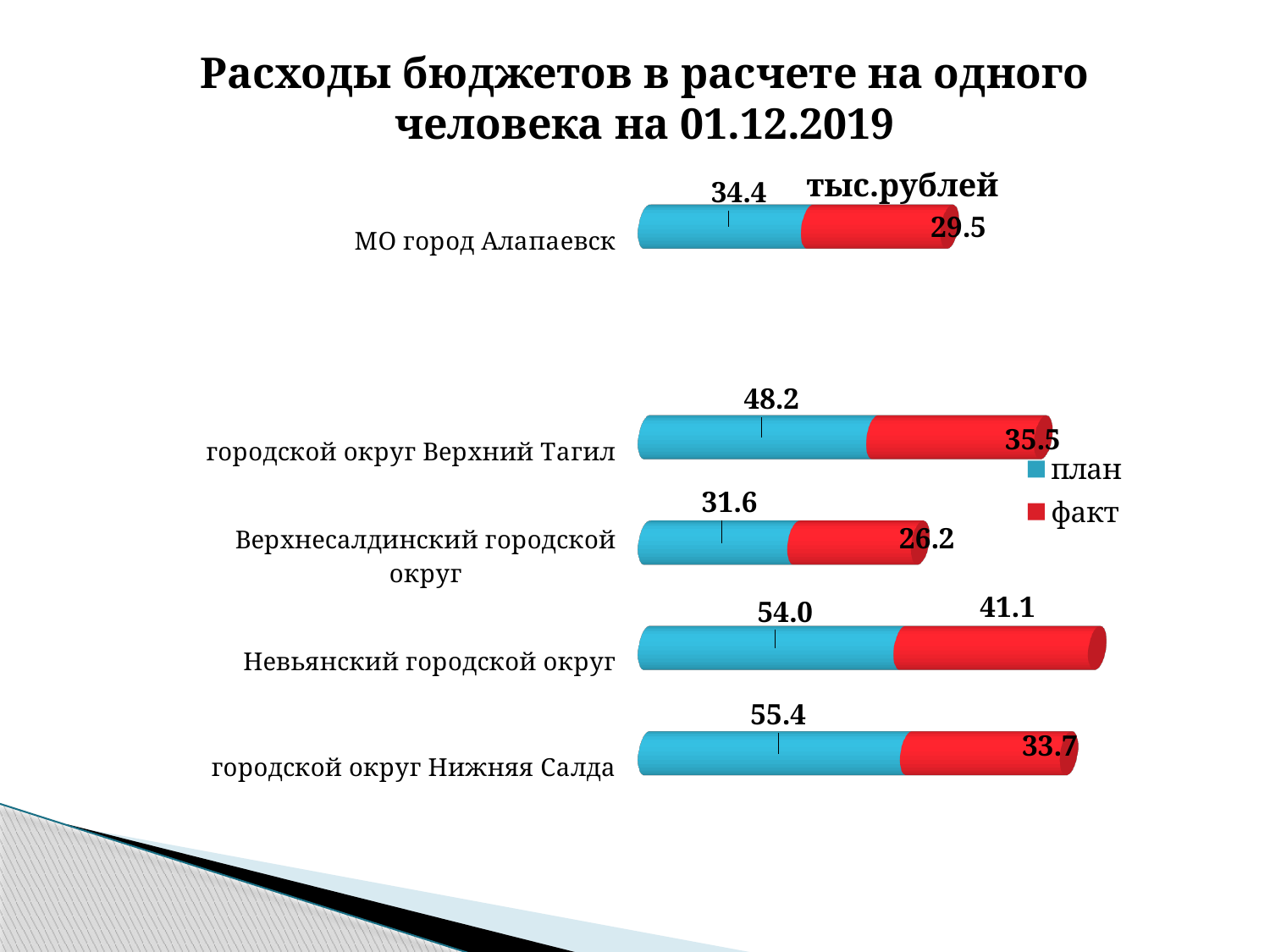
What is the факт value for городской округ Нижняя Салда? 33.7 What is the факт value for МО город Алапаевск? 29.5 What kind of chart is shown on the slide? Stacked bar chart Which category has the highest план value? городской округ Нижняя Салда What is the план value for Невьянский городской округ? 54.0 What unit is indicated above the chart? тыс.рублей How many series does the legend list? 2 What is the difference between the план and факт values for Невьянский городской округ? 12.9 Which is larger: the план value for городской округ Верхний Тагил or the план value for МО город Алапаевск? городской округ Верхний Тагил Which category has the lowest факт value? Верхнесалдинский городской округ Which category has the highest факт value? Невьянский городской округ What is the total of the stacked bar for МО город Алапаевск? 63.9